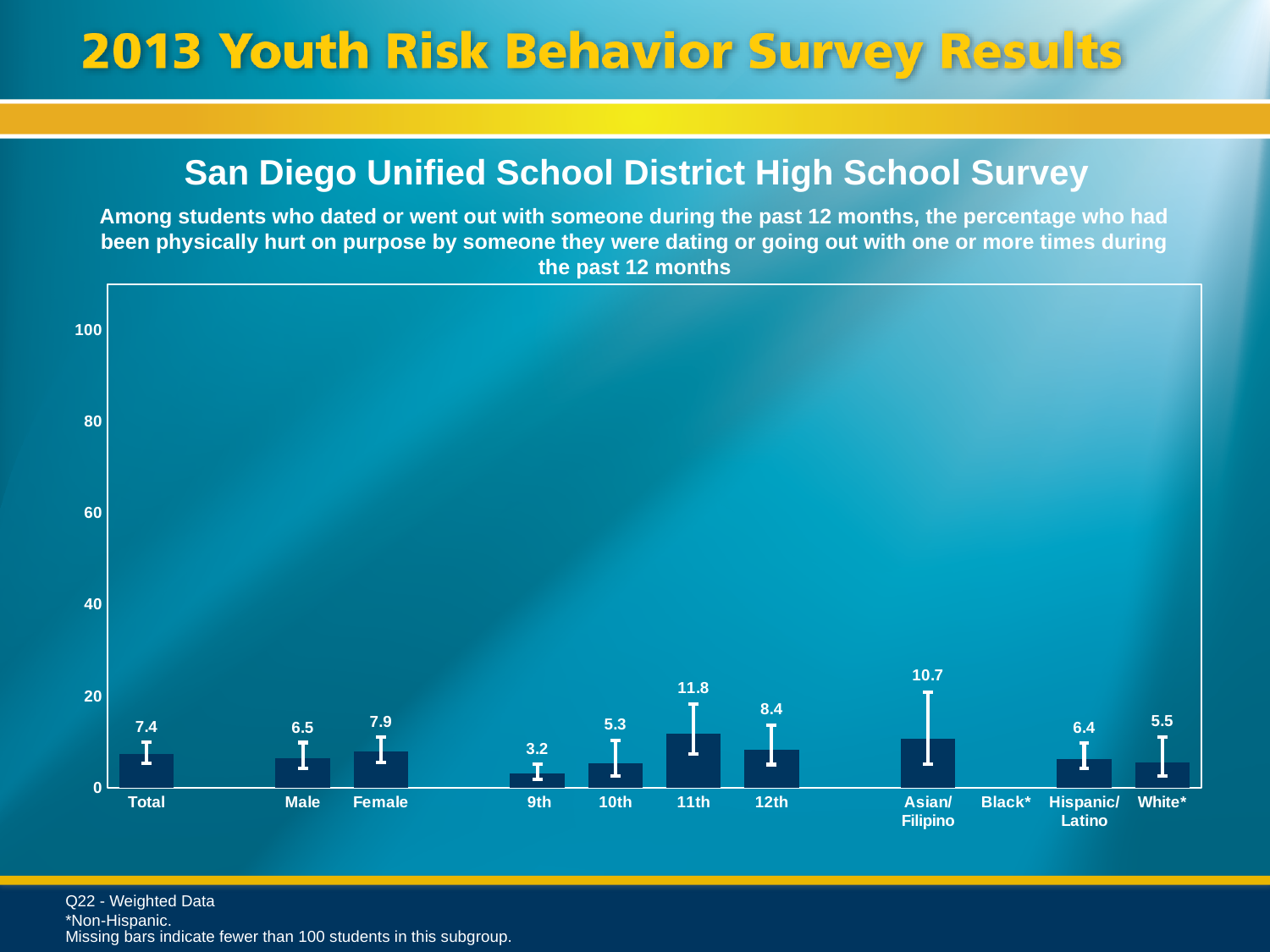
Is the value for 11th grade greater or less than 20? less What is the value for 11th grade? 11.8 What is the value for Total? 7.4 Which category has the lowest value among those with bars? 9th What is the difference between the Female and Male values? 1.4 Which category has no bar shown? Black* How many categories are labeled on the x axis? 11 Which is larger, the value for 10th grade or the value for 12th grade? 12th What is the difference between the Hispanic/Latino and White* values? 0.9 What kind of chart is shown? bar chart What is the value for Asian/Filipino? 10.7 Which category has the highest value? 11th